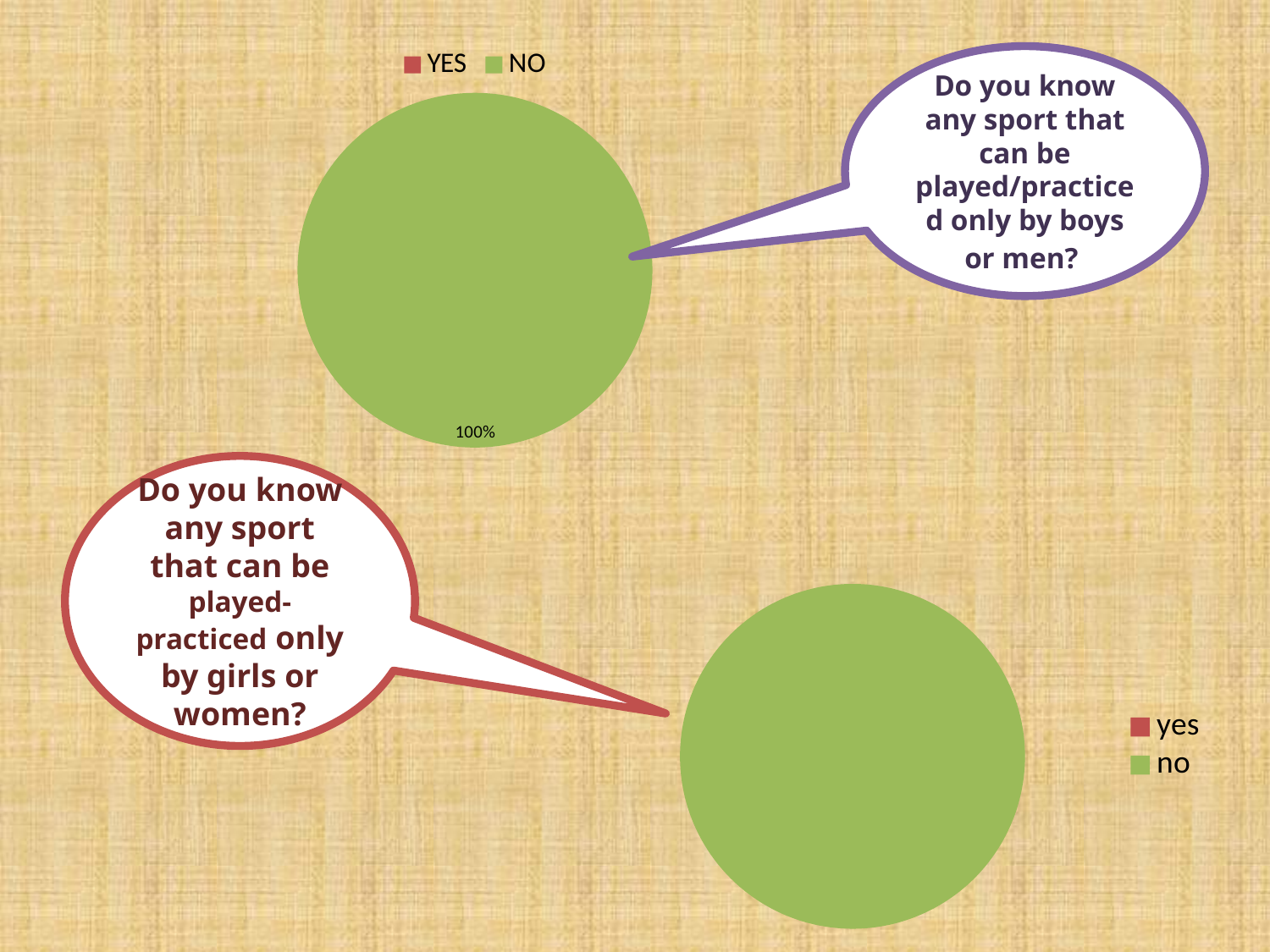
In the bottom pie chart, which category fills the whole pie? no What kind of chart is the bottom chart on the slide? pie chart In the top pie chart, which category has the largest share? NO What kind of chart is the top chart on the slide? pie chart What colour represents NO in the top pie chart's legend? green What colour represents YES in the top pie chart's legend? red In the top pie chart, which of YES or NO has the larger share? NO In the top pie chart, what share of the pie does NO take? 100% How many entries does the legend of the top pie chart list? 2 In the top pie chart, what percentage is shown for NO? 100% How many entries does the legend of the bottom pie chart list? 2 In the bottom pie chart, which of yes or no has the larger share? no